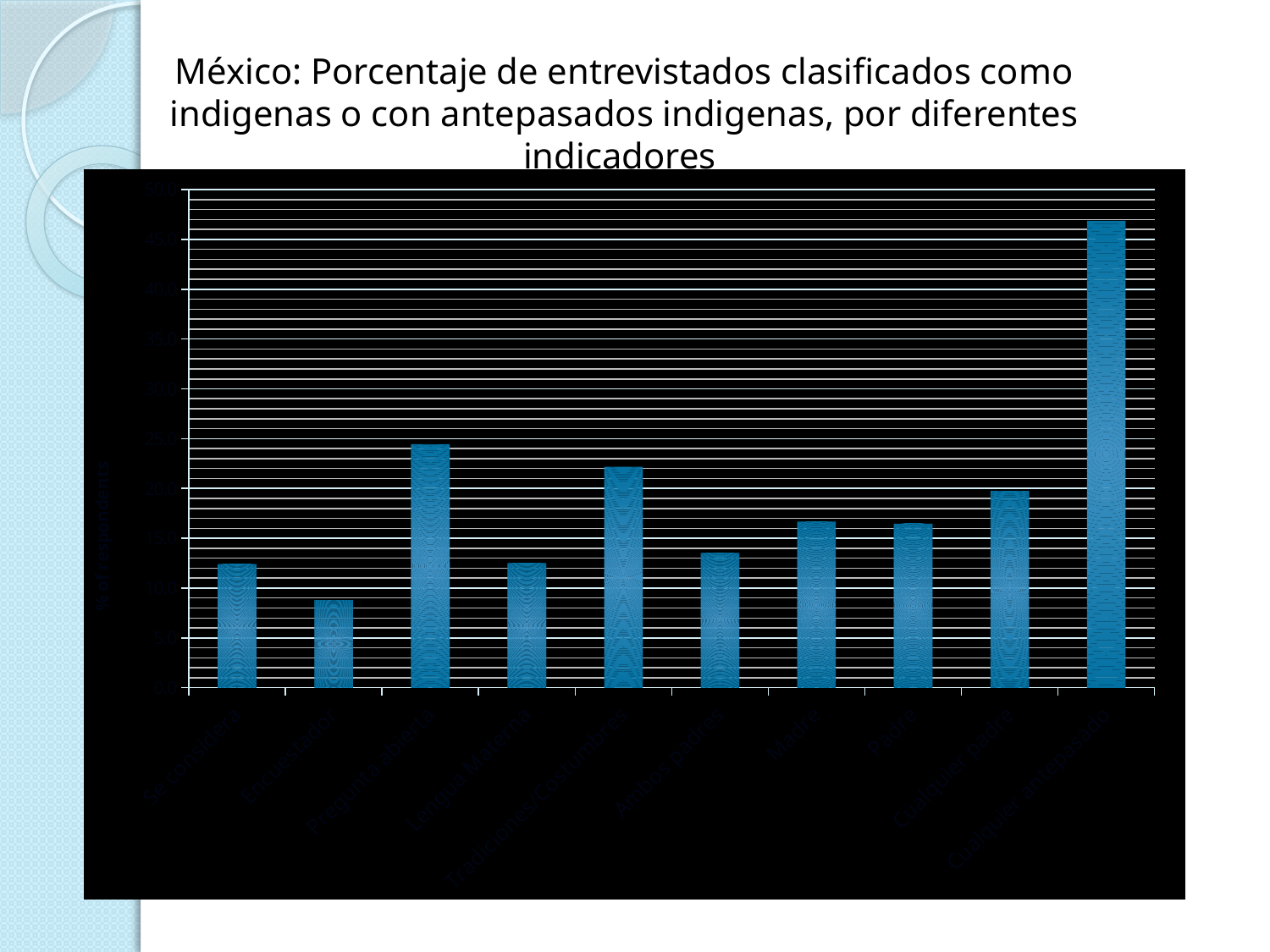
Which category has the highest value in the chart? Cualquier antepasado Is the value for Cualquier antepasado greater or less than 45.0? greater What kind of chart is shown on the slide? bar chart Is the value for Encuestador greater or less than 10.0? less What is the maximum value shown on the vertical axis of the chart? 50.0 Which is larger, the value for Tradiciones/Costumbres or the value for Ambos padres? Tradiciones/Costumbres What country is named in the title of the chart? México Which category has the lowest value in the chart? Encuestador Is the value for Pregunta abierta greater or less than 20.0? greater Which is larger, the value for Pregunta abierta or the value for Lengua Materna? Pregunta abierta How many bars (categories) are plotted in the chart? 10